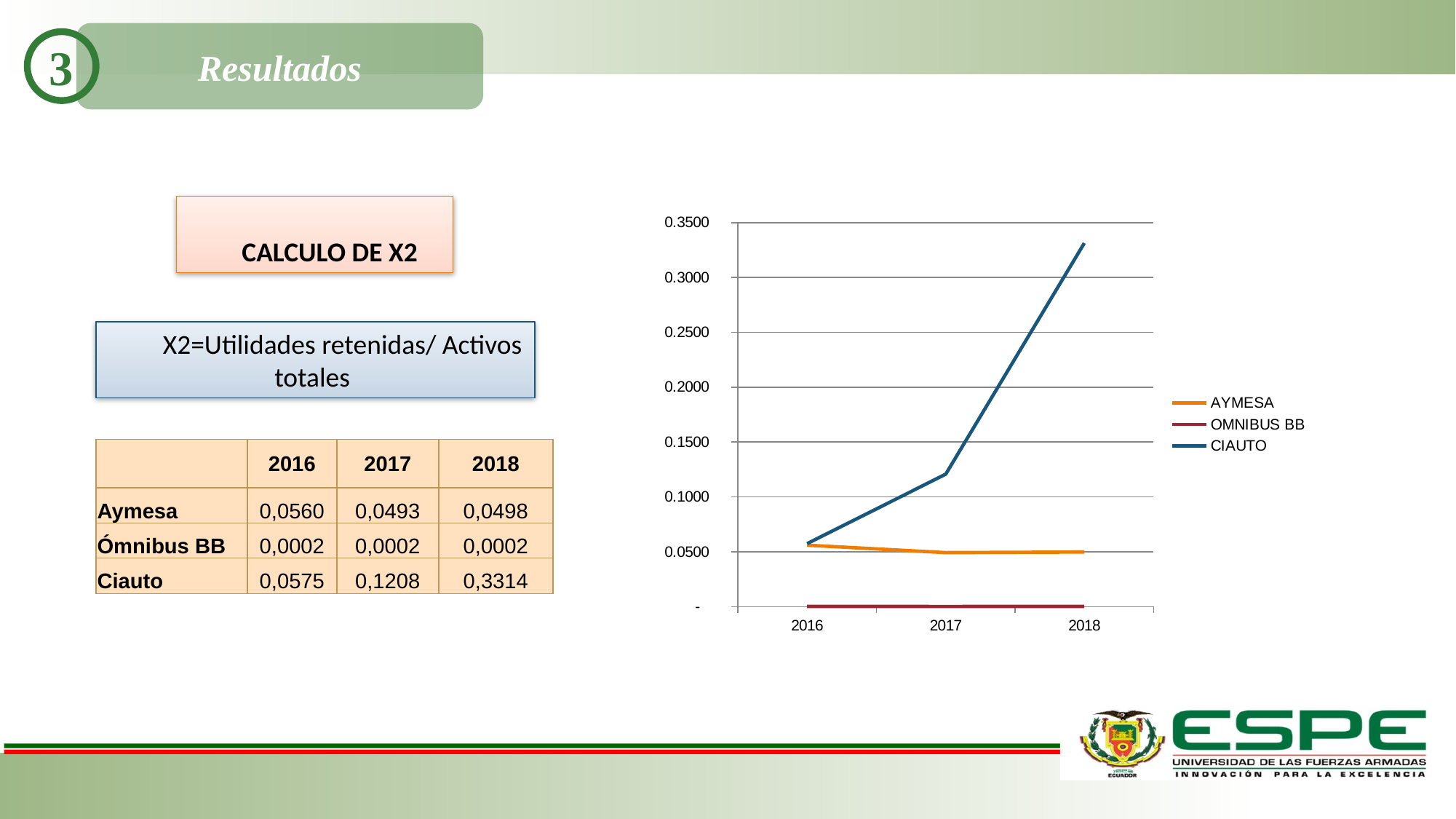
Using the table values, what is the difference between Ciauto's X2 in 2018 and in 2017? 0,2106 In 2017, which series has the larger value, CIAUTO or AYMESA? CIAUTO Which series has the lowest values across all years? OMNIBUS BB Which series has the highest value in 2018? CIAUTO What kind of chart is shown on the slide? line chart Is the value for CIAUTO in 2018 greater or less than 0.3000? greater How many series does the chart's legend list? 3 Is the value for CIAUTO in 2017 greater or less than 0.1500? less Does the CIAUTO line rise or fall from 2016 to 2018? rise How many years are plotted along the x axis of the chart? 3 Is the value for AYMESA in 2018 greater or less than 0.1000? less According to the table on the slide, what is the X2 value for Ciauto in 2018? 0,3314